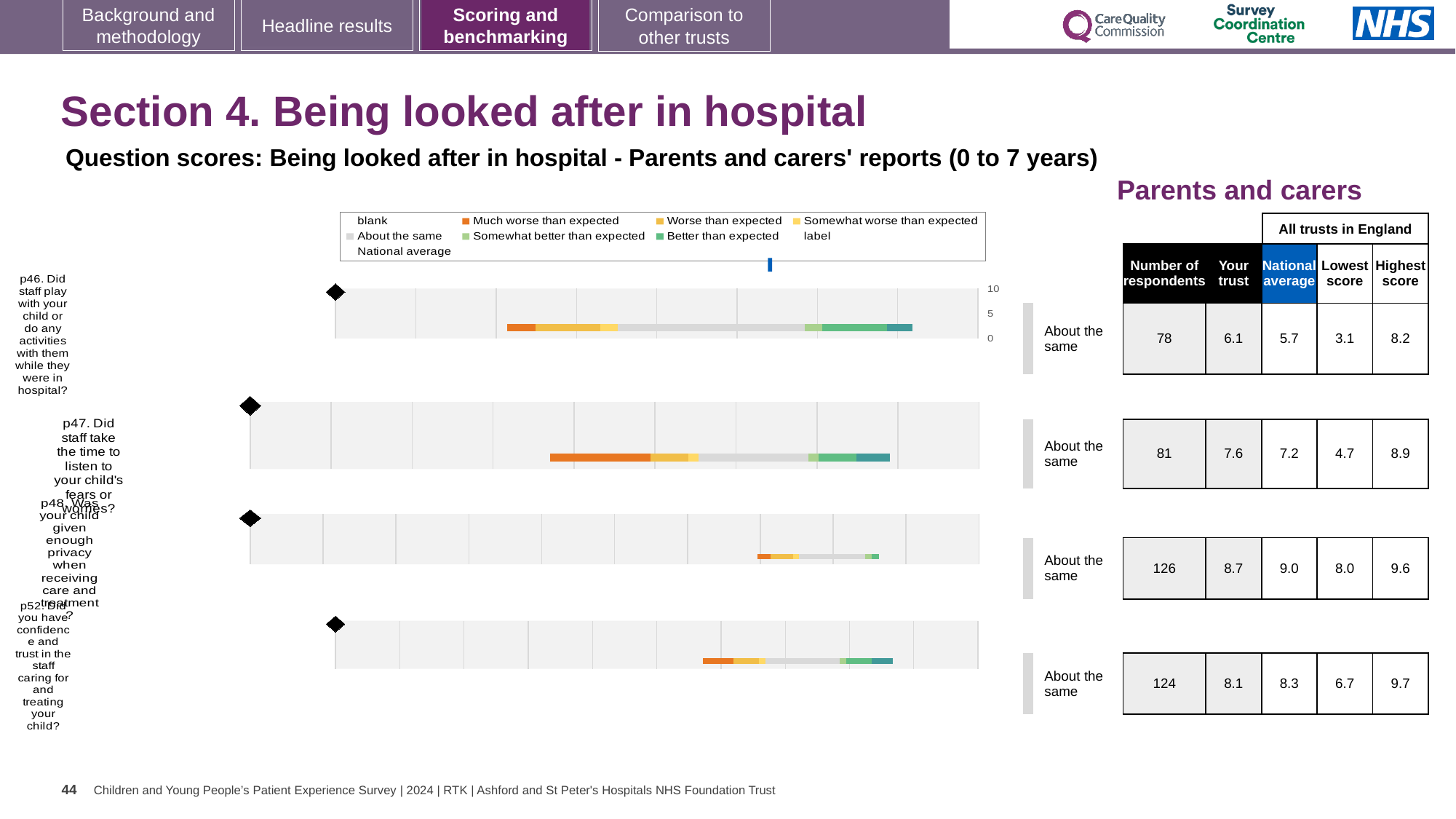
Which question has the fewest respondents? p46 What colour represents 'Much worse than expected' in the legend? orange How many questions (p46, p47, p48, p52) are plotted on this slide? 4 What kind of chart is used to show the question scores on this slide? bar chart What is the highest score across all trusts in England for p52 (Did you have confidence and trust in the staff caring for and treating your child?)? 9.7 For p47, which is larger: the 'Your trust' score or the national average? Your trust How many respondents answered p48 (Was your child given enough privacy when receiving care and treatment?)? 126 Which question has the highest 'Your trust' score? p48 What is the 'Your trust' score for p46 (Did staff play with your child or do any activities with them while they were in hospital?)? 6.1 What is the national average score for p47 (Did staff take the time to listen to your child's fears or worries?)? 7.2 What is the difference between the 'Your trust' score and the national average for p46? 0.4 What benchmark category is shown for p52? About the same